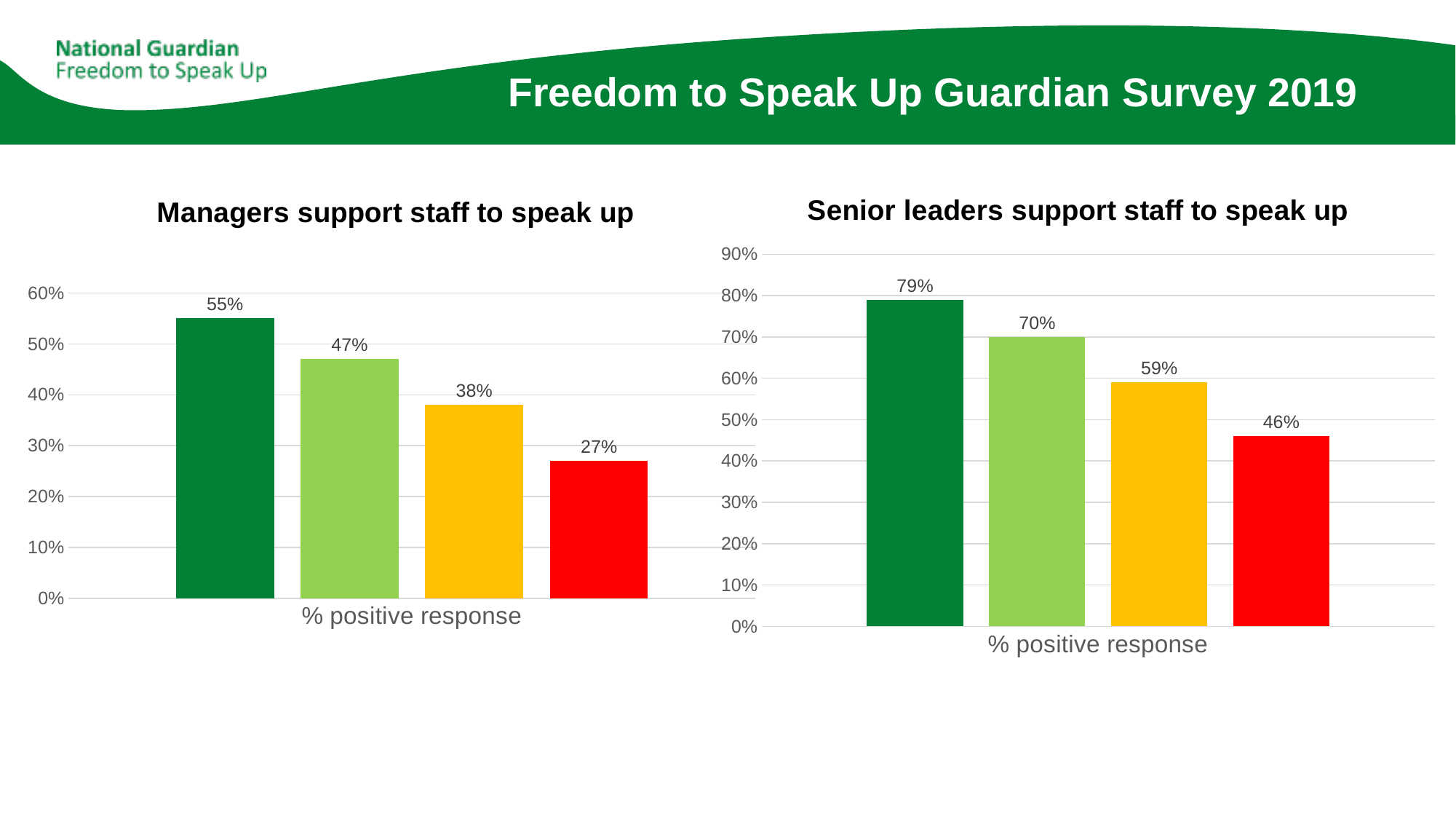
In the 'Managers support staff to speak up' chart, which coloured bar has the lowest value? Red What is the x-axis label shown under the bars in the 'Managers support staff to speak up' chart? % positive response In the 'Senior leaders support staff to speak up' chart, what value is shown on the yellow bar? 59% In the 'Managers support staff to speak up' chart, what value is shown on the red bar? 27% In the 'Managers support staff to speak up' chart, what value is shown on the dark green bar? 55% What kind of chart is the 'Senior leaders support staff to speak up' chart? Bar chart In the 'Senior leaders support staff to speak up' chart, what value is shown on the light green bar? 70% Which is larger: the yellow bar in the 'Managers support staff to speak up' chart or the yellow bar in the 'Senior leaders support staff to speak up' chart? Senior leaders support staff to speak up In the 'Senior leaders support staff to speak up' chart, which coloured bar has the highest value? Dark green In the 'Managers support staff to speak up' chart, what is the difference between the dark green bar and the red bar? 28% In the 'Senior leaders support staff to speak up' chart, what is the difference between the dark green bar and the light green bar? 9% How many bars are plotted in the 'Managers support staff to speak up' chart? 4